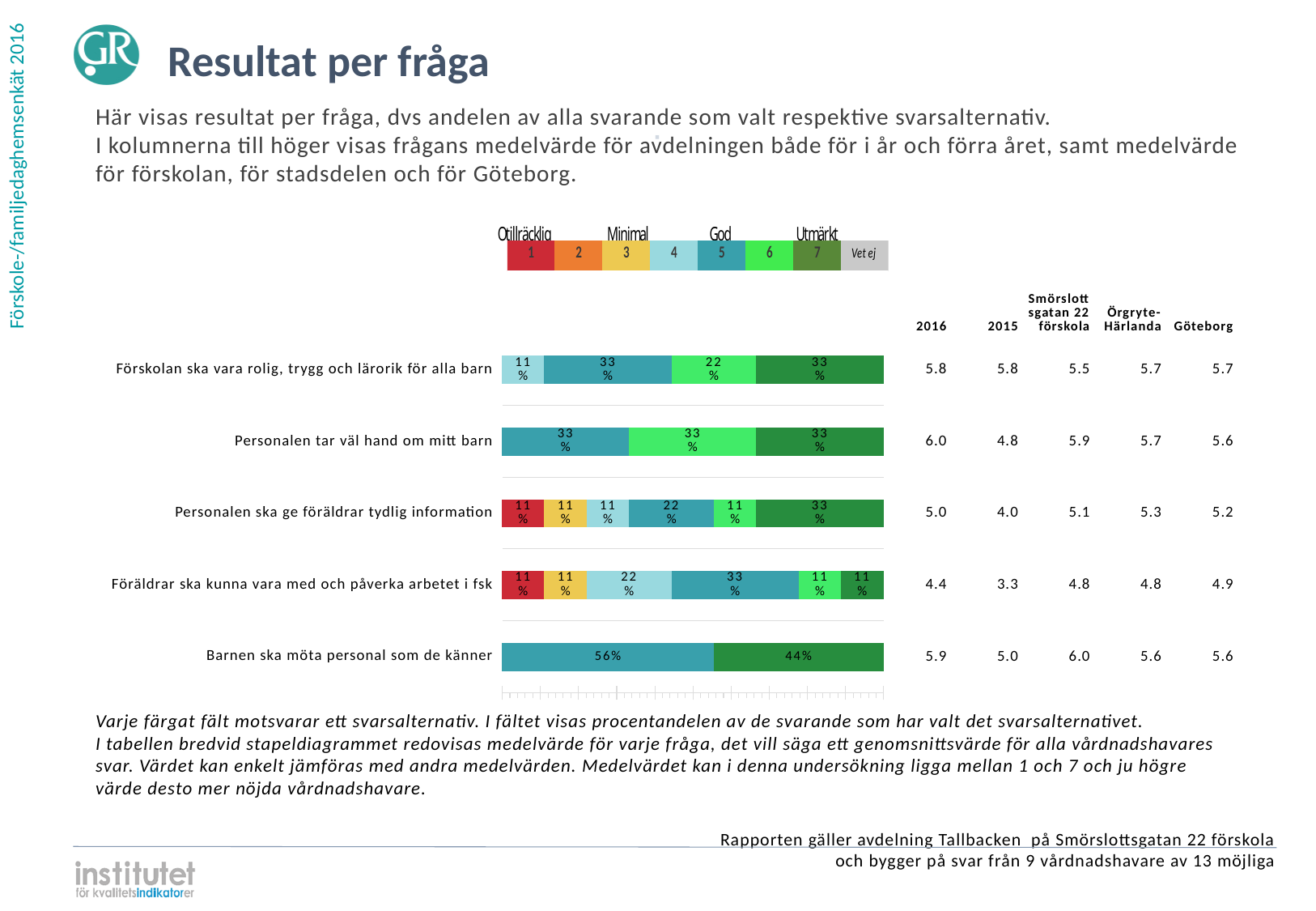
For 'Föräldrar ska kunna vara med och påverka arbetet i fsk', which is larger: the share for answer 5 or the share for answer 7? Answer 5 What percentage chose answer 7 for 'Personalen ska ge föräldrar tydlig information'? 33% Which question has the largest share of respondents choosing answer 5? Barnen ska möta personal som de känner What is the difference in percentage points between the answer 5 share and the answer 7 share for 'Barnen ska möta personal som de känner'? 12 What percentage chose answer 4 for 'Föräldrar ska kunna vara med och påverka arbetet i fsk'? 22% What percentage of respondents chose answer 5 for 'Barnen ska möta personal som de känner'? 56% Which question has the lowest 2015 mean value in the table? Föräldrar ska kunna vara med och påverka arbetet i fsk How many questions (categories) are shown in the bar chart? 5 What kind of chart is used to show the results per question? Stacked bar chart How many entries does the legend above the chart list? 8 What is the 2016 mean value for 'Personalen tar väl hand om mitt barn'? 6.0 What percentage of respondents chose answer 7 for 'Barnen ska möta personal som de känner'? 44%